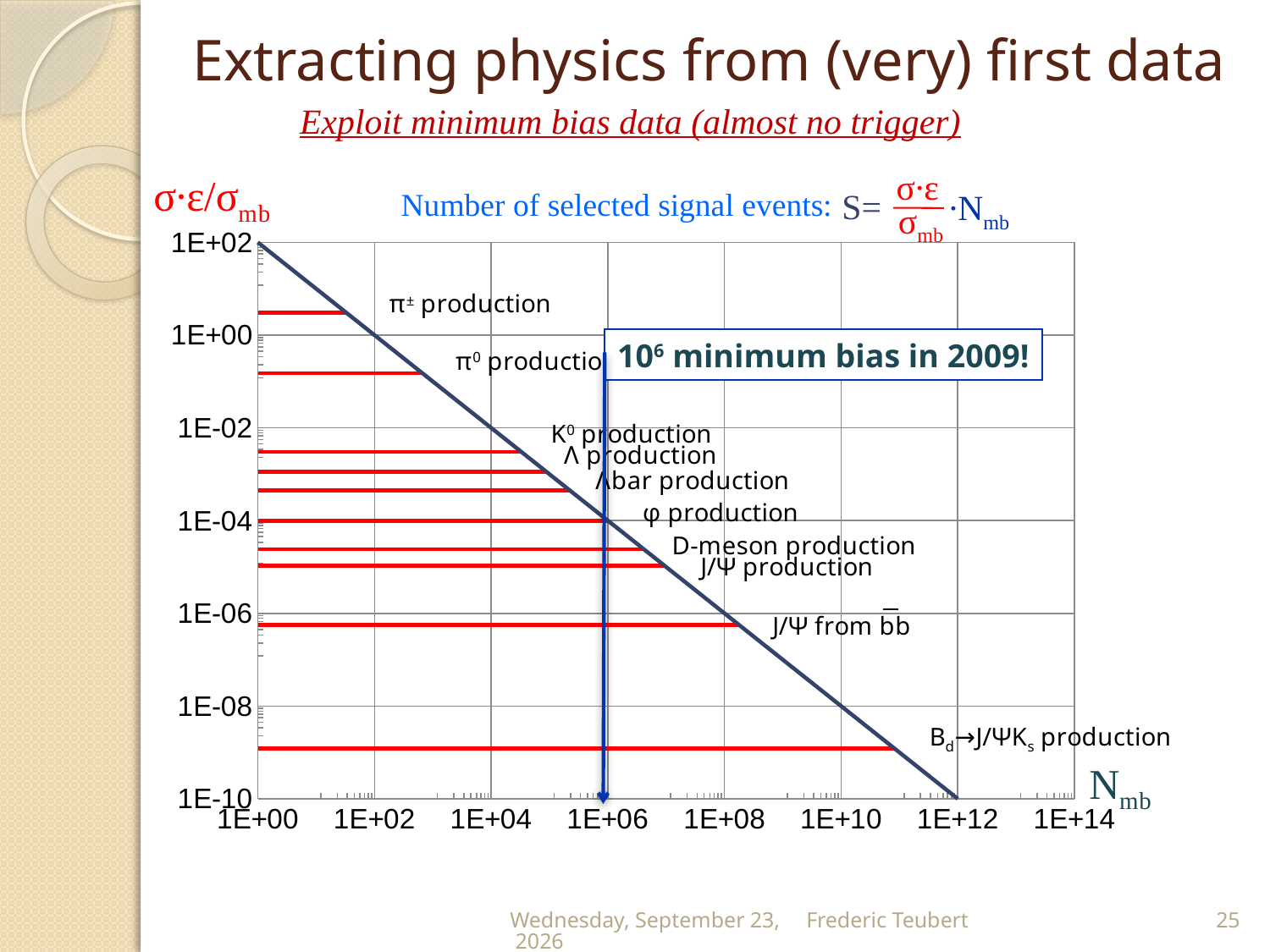
Does the diagonal line on the chart rise or fall as Nmb increases along the x axis? fall What is the highest value shown on the y axis of the chart? 1E+02 Which has the higher σ·ε/σmb value, π± production or π0 production? π± production Is the σ·ε/σmb value for Bd→J/ΨKs production greater or less than 1E-08? less At what Nmb value is the vertical arrow labelled '10^6 minimum bias in 2009!' drawn? 1E+06 Which labelled production process has the highest σ·ε/σmb value on the chart? π± production What kind of chart is shown on the slide? line chart Which has the higher σ·ε/σmb value, D-meson production or J/Ψ from bb? D-meson production Is the σ·ε/σmb value for K0 production greater or less than 1E-02? less How many production processes are labelled with horizontal red lines on the chart? 10 Is the σ·ε/σmb value for π± production greater or less than 1E+00? greater Which labelled production process has the lowest σ·ε/σmb value on the chart? Bd→J/ΨKs production